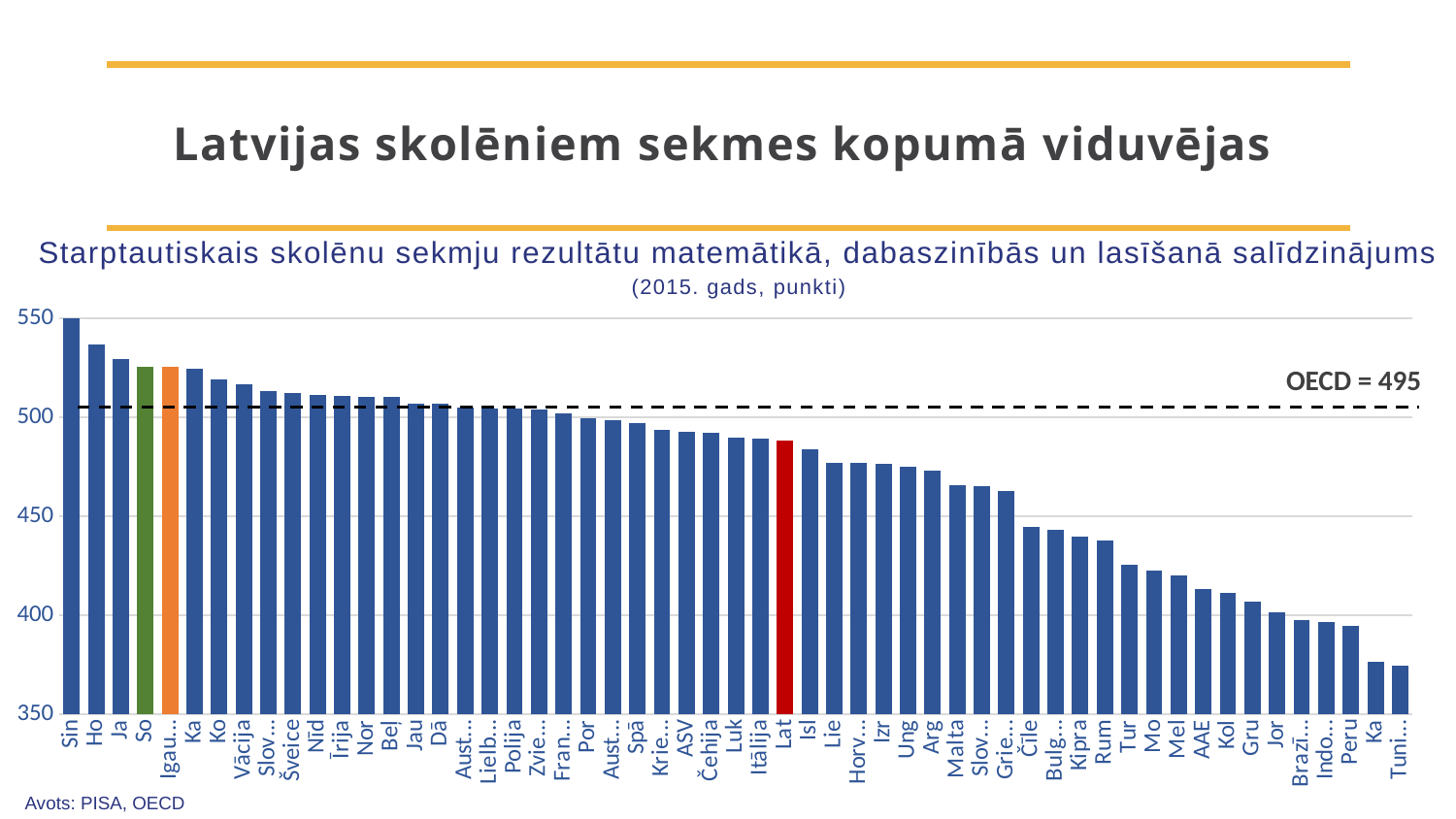
Which country has the highest score on the chart? Sin Which has a higher value, Lat or Malta? Lat Is the value for Malta greater or less than 500? less Is the value for Vācija greater or less than 500? greater What colour is the bar for Lat? red Is the value for Mel greater or less than 400? greater Which has a higher value, Čehija or Čīle? Čehija Do the bar values rise or fall from left to right along the x axis? fall What value is given for the OECD average on the chart? 495 What kind of chart is shown on the slide? bar chart